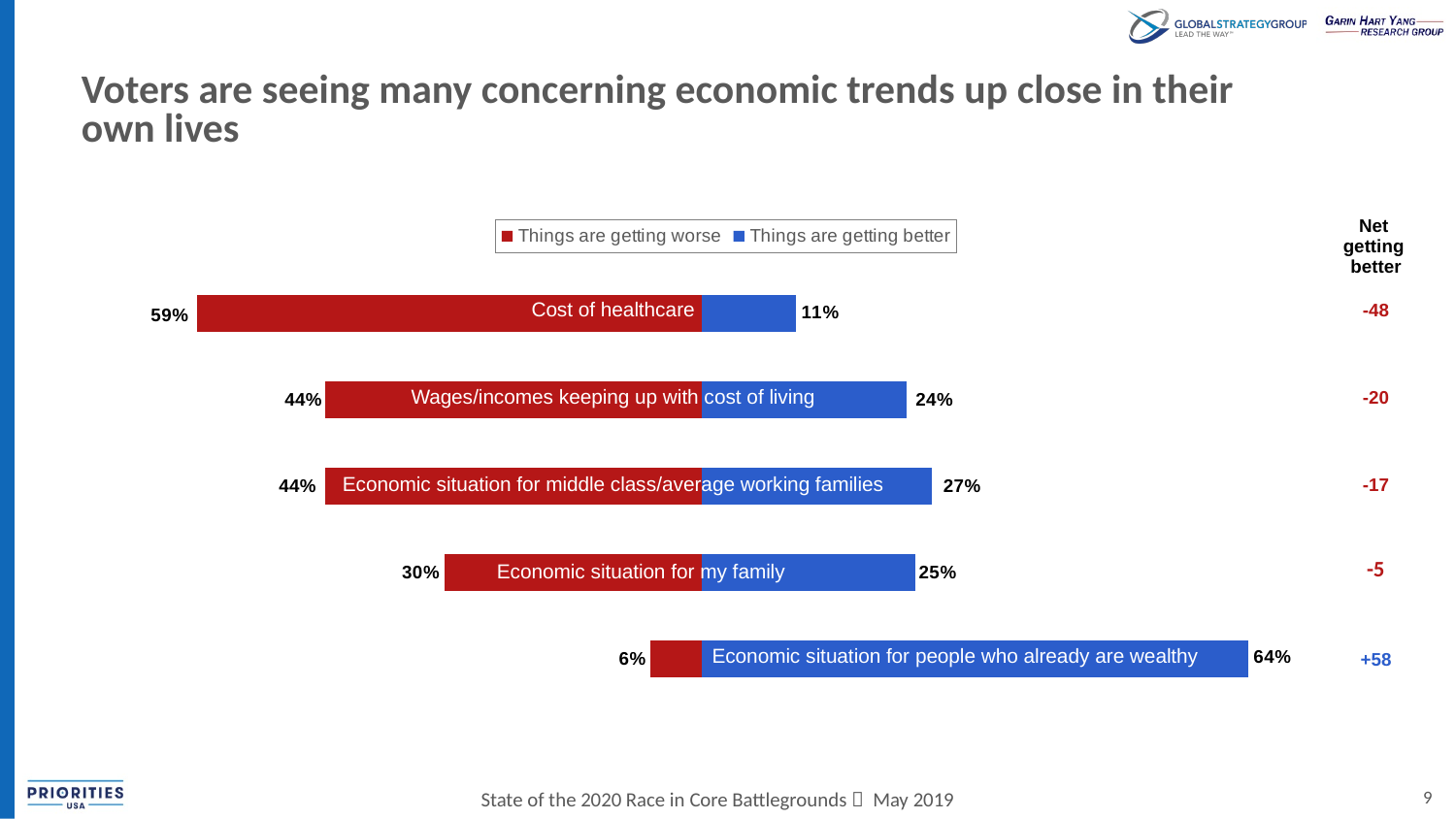
How many series does the legend list? 2 Which is larger for the economic situation for middle class/average working families: the 'getting worse' value or the 'getting better' value? Things are getting worse How many categories are shown in the chart? 5 What percentage say things are getting worse for the cost of healthcare? 59% Which category has the highest 'Things are getting worse' value? Cost of healthcare What percentage say things are getting better for wages/incomes keeping up with cost of living? 24% What kind of chart is shown on the slide? Bar chart Which colour represents 'Things are getting better' in the chart? Blue Which category has the lowest 'Things are getting better' value? Cost of healthcare What is the difference between the 'getting worse' and 'getting better' values for the economic situation for my family? 5 What is the 'Net getting better' value shown for the cost of healthcare? -48 What percentage say things are getting better for the economic situation for people who already are wealthy? 64%